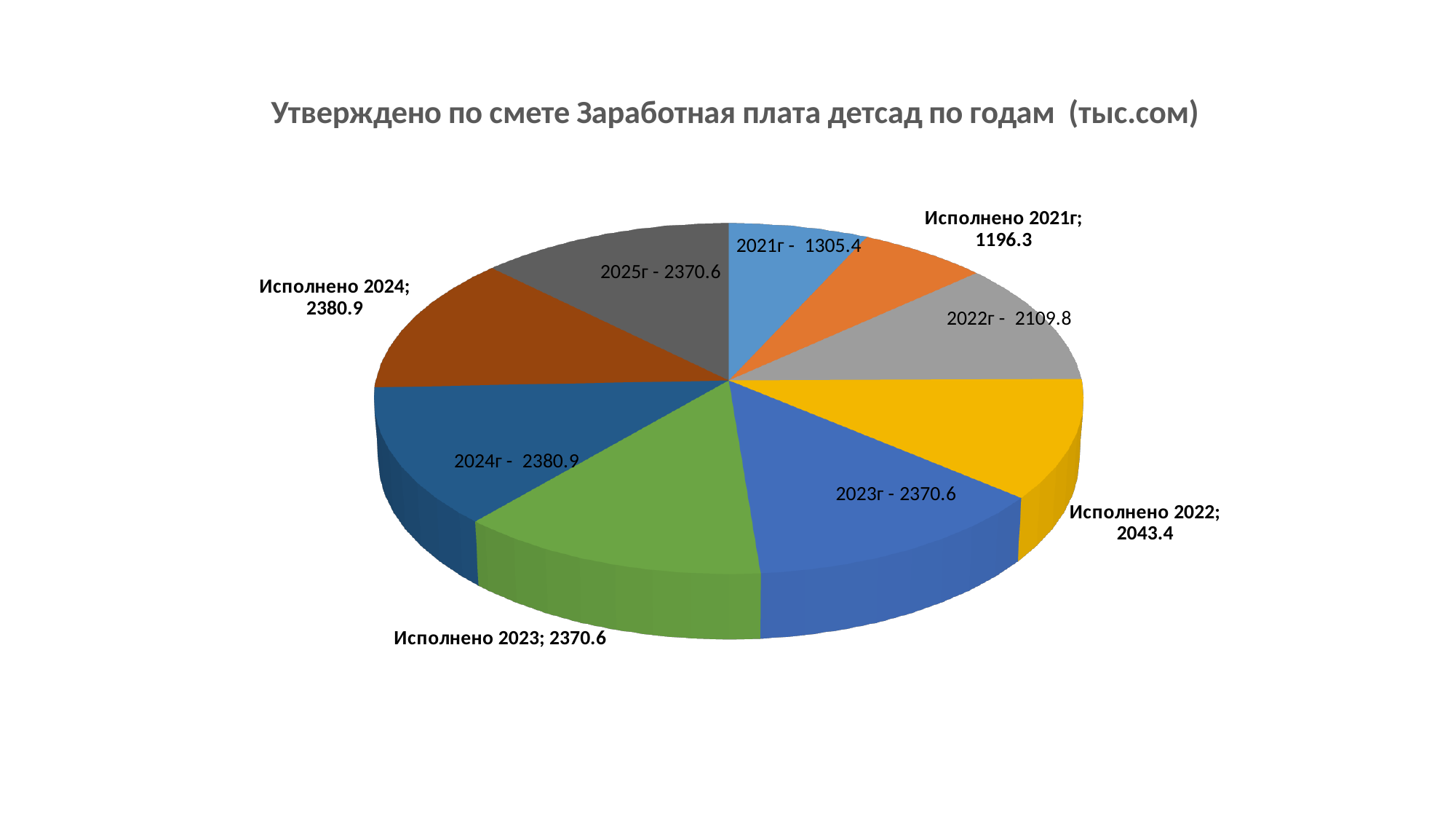
What is the value for Исполнено 2022? 2043.4 How many slices does the pie chart have? 9 What is the title of the chart? Утверждено по смете Заработная плата детсад по годам (тыс.сом) Which slice has the smallest value? Исполнено 2021г What is the value for 2025г? 2370.6 What is the difference between the values for 2021г and Исполнено 2021г? 109.1 Which is larger, the value for 2022г or the value for 2021г? 2022г What type of chart is shown on the slide? pie chart What is the value for 2021г? 1305.4 What is the value for 2022г? 2109.8 What is the difference between the values for 2022г and Исполнено 2022? 66.4 What is the value for Исполнено 2021г? 1196.3